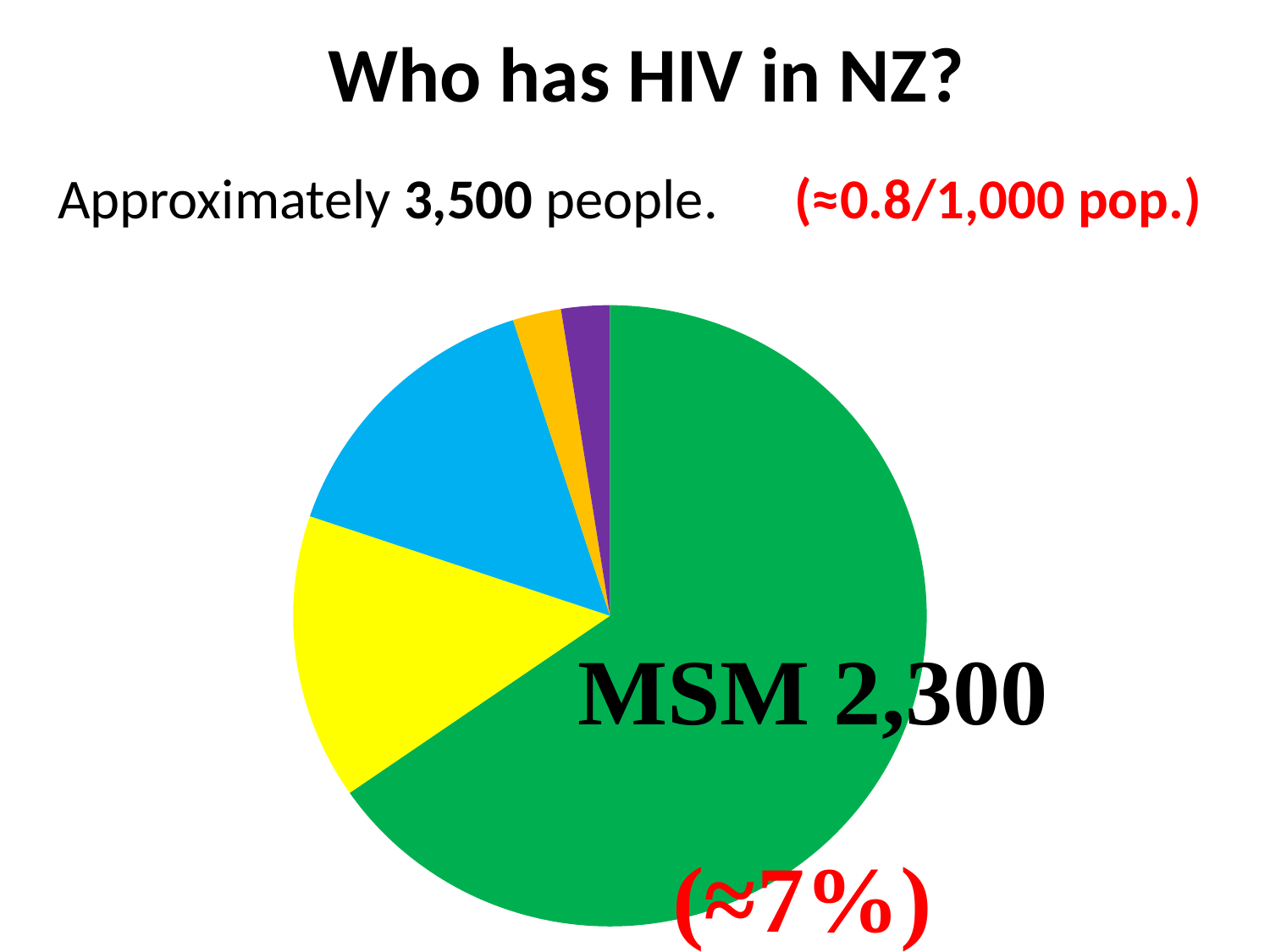
Which category has the largest slice in the pie chart? MSM What is the title of the slide containing the pie chart? Who has HIV in NZ? What value is printed for the MSM slice of the pie chart? 2,300 How many slices does the pie chart have? 5 Which slice is larger, the blue slice or the orange slice? the blue slice Does the MSM slice take up more or less than half of the pie? more What colour is the MSM slice of the pie chart? green Which slice is larger, the green MSM slice or the yellow slice? the green MSM slice What kind of chart is shown on the slide? pie chart